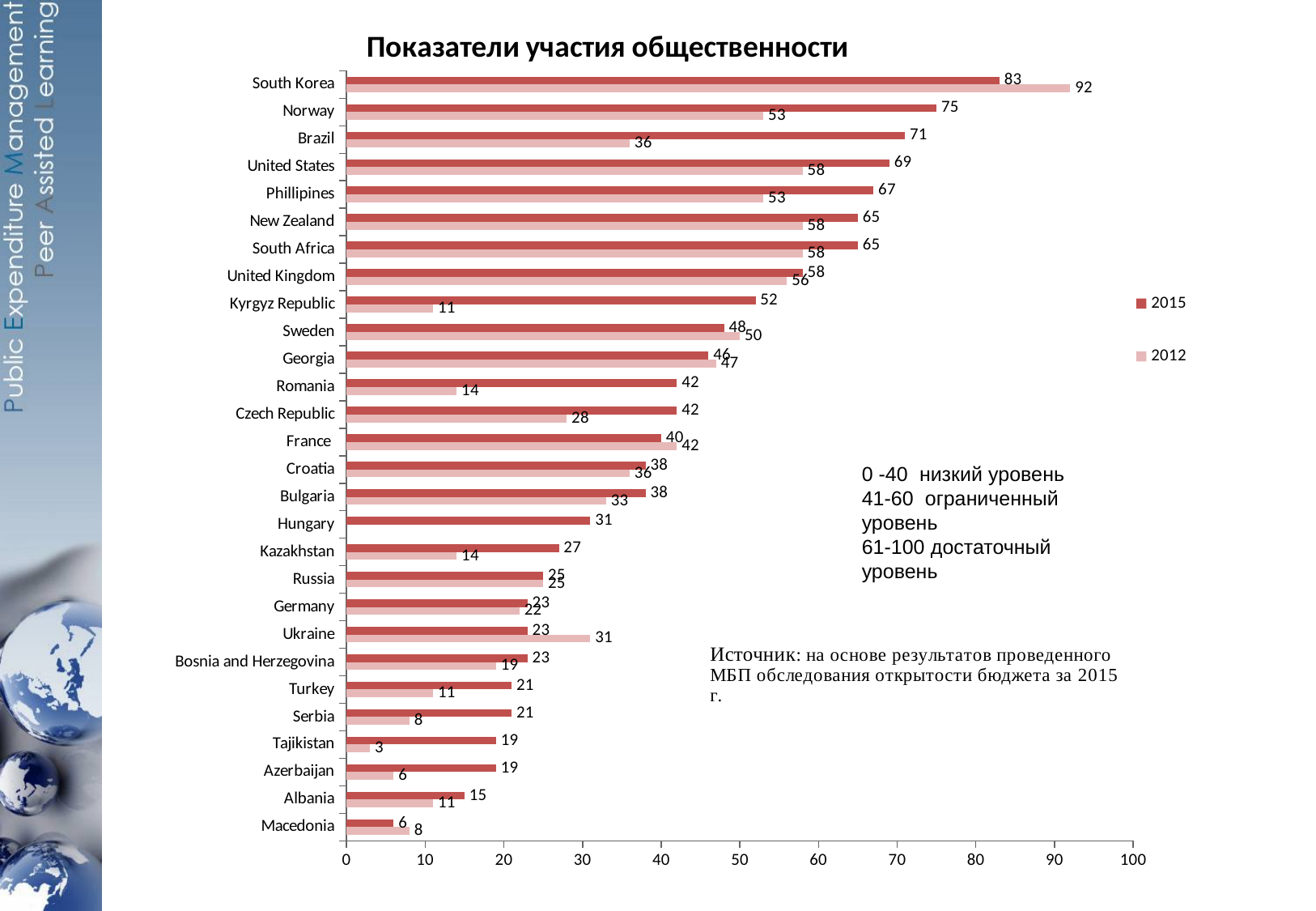
Which series is shown in the darker red colour? 2015 How many series does the legend list? 2 What is the 2015 value for Brazil? 71 What is the 2012 value for Kyrgyz Republic? 11 Which is larger for Ukraine, the 2015 value or the 2012 value? 2012 What kind of chart is shown on the slide? Bar chart What is the title of the chart? Показатели участия общественности What is the difference between the 2015 and 2012 values for Romania? 28 What is the 2012 value for South Korea? 92 Which country has the highest 2015 value? South Korea Which country has the lowest 2012 value? Tajikistan How many countries are shown on the chart? 28